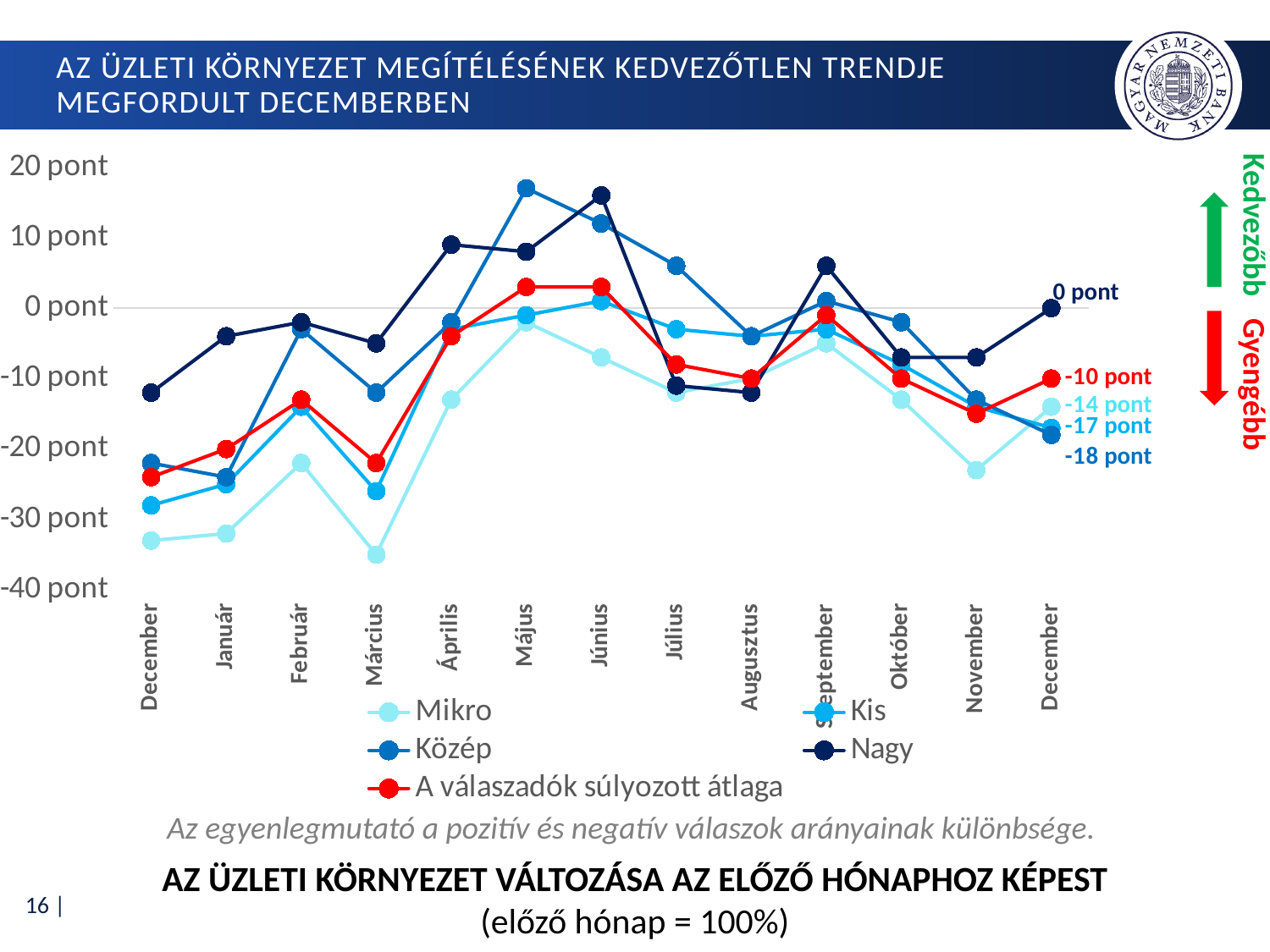
How many series does the legend list? 5 Which series has the highest value in Június? Nagy Which series has the lowest value in the first December? Mikro What is the value of 'A válaszadók súlyozott átlaga' in the final December? -10 pont In the final December, what is the difference between the Nagy value and the 'A válaszadók súlyozott átlaga' value? 10 pont In the final December, which is higher: Nagy or 'A válaszadók súlyozott átlaga'? Nagy What kind of chart is shown on the slide? line chart Which legend entry is drawn with the red line? A válaszadók súlyozott átlaga Is the Mikro value in Március greater or less than -30 pont? less Is the Közép value in Május greater or less than 10 pont? greater What is the value of the Nagy series in the final December? 0 pont How many months are plotted along the x axis? 13